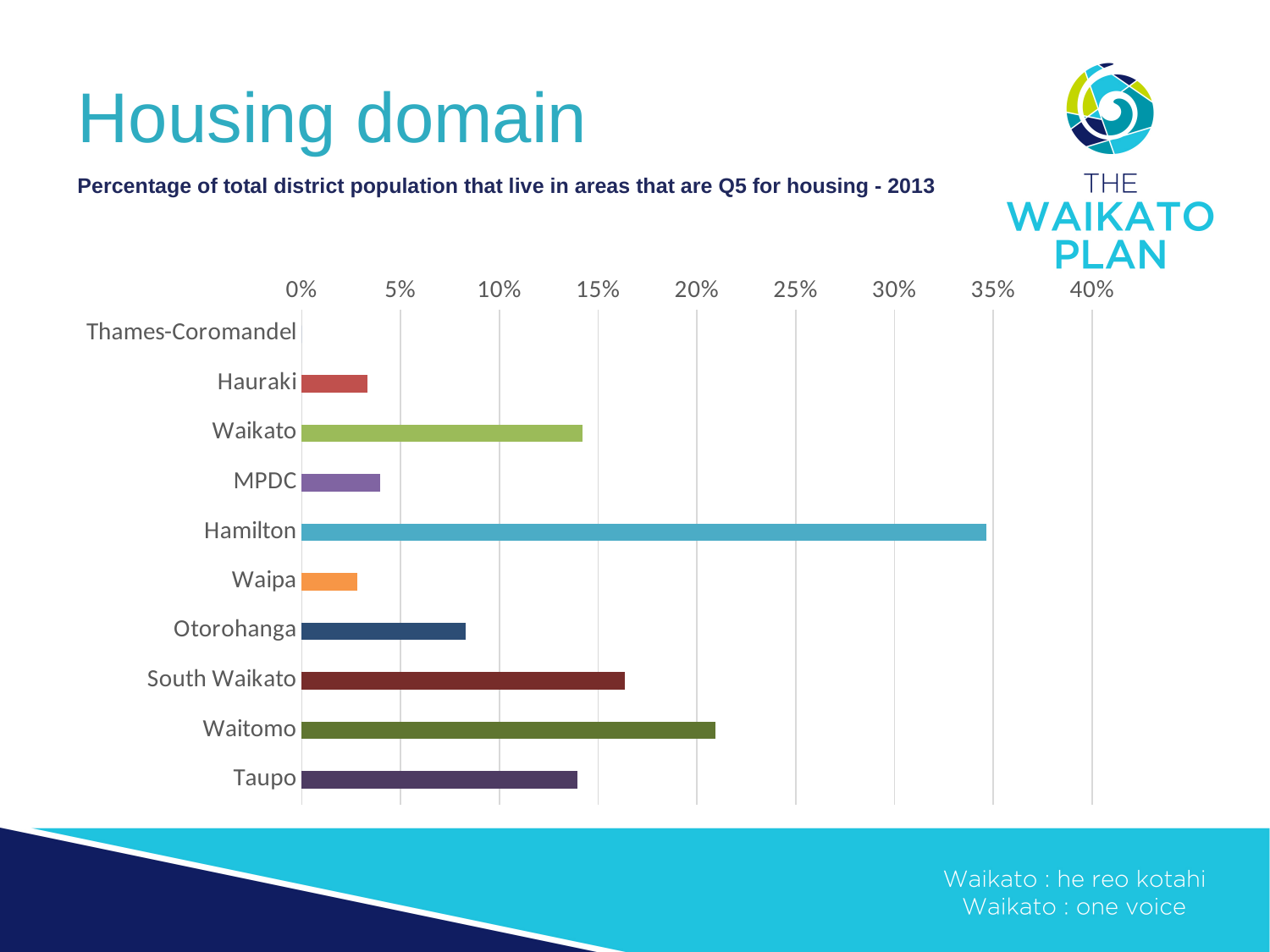
What kind of chart is shown on the slide? Bar chart Is the value for Otorohanga greater or less than 10%? less Which has the larger value, Hamilton or Waikato? Hamilton Is the value for South Waikato greater or less than 15%? greater Which district has the lowest value on the chart? Thames-Coromandel Is the value for Waipa greater or less than 5%? less Which has the larger value, Waitomo or South Waikato? Waitomo What is the title of the chart? Percentage of total district population that live in areas that are Q5 for housing - 2013 How many districts are plotted on the chart? 10 Which district has the highest percentage of population living in Q5 housing areas? Hamilton